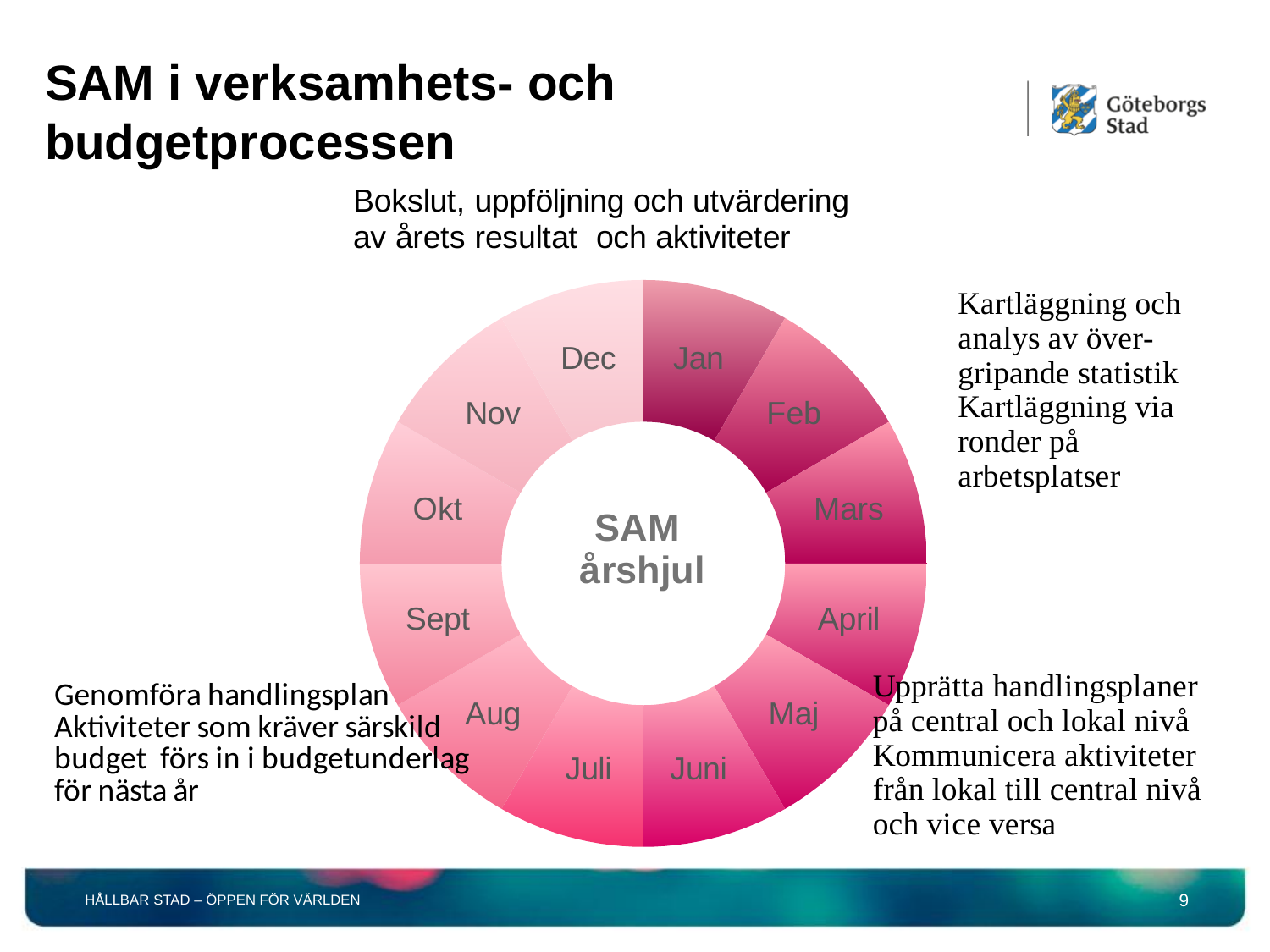
What kind of chart is shown on the slide? Doughnut chart Which segment label appears between Feb and April on the doughnut chart? Mars Which segment label comes immediately after Sept going clockwise on the doughnut chart? Okt How many segments does the doughnut chart have? 12 Which segment label is at the top-left of the doughnut chart, next to Jan? Dec What text is written in the centre of the doughnut chart? SAM årshjul Which segment of the doughnut chart is the darkest in colour? Jan